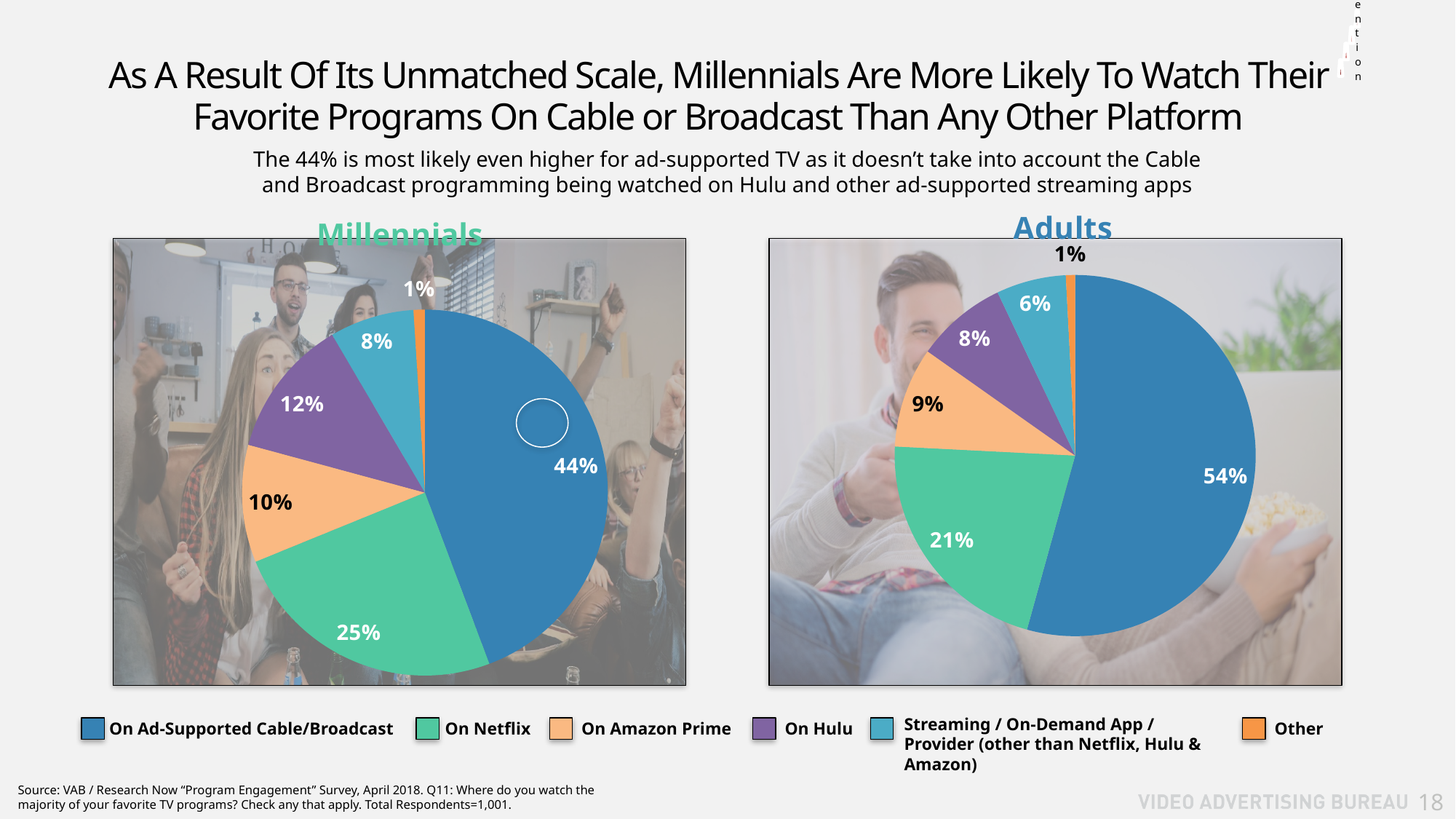
In the Millennials pie chart, which is larger: On Hulu or On Amazon Prime? On Hulu How many slices does the Adults pie chart have? 6 In the Millennials pie chart, what share is On Amazon Prime? 10% How many entries does the legend list? 6 In the Millennials pie chart, what share is On Netflix? 25% In the Adults pie chart, what share is On Ad-Supported Cable/Broadcast? 54% What type of chart is used for the Millennials data? Pie chart In the Adults pie chart, what share is On Hulu? 8% In the Millennials pie chart, what share is On Ad-Supported Cable/Broadcast? 44% What is the difference between the Adults and Millennials shares for On Ad-Supported Cable/Broadcast? 10 percentage points In the Adults pie chart, which platform has the largest share? On Ad-Supported Cable/Broadcast In the Millennials pie chart, which platform has the smallest share? Other